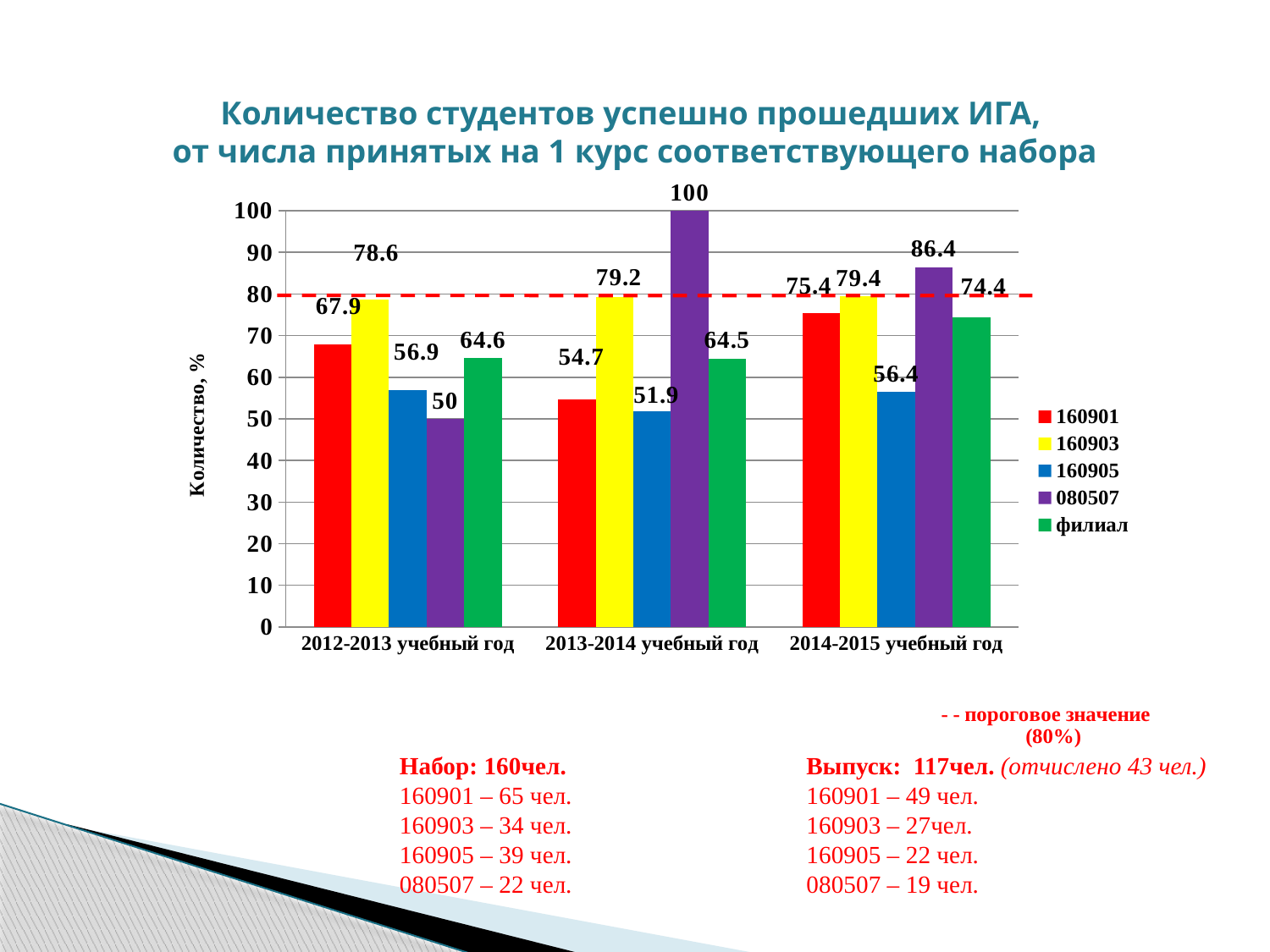
Do the values for 160903 rise or fall from 2012-2013 to 2014-2015 учебный год? rise What is the difference between the 160901 values in 2014-2015 учебный год and 2013-2014 учебный год? 20.7 What kind of chart is shown on the slide? bar chart Which series has the highest value in 2014-2015 учебный год? 080507 How many academic years (categories) are shown on the x axis? 3 Which is larger: the value for 160905 in 2012-2013 учебный год or in 2014-2015 учебный год? 2012-2013 учебный год Which series has the lowest value in 2012-2013 учебный год? 080507 What is the value for 080507 in 2013-2014 учебный год? 100 How many series does the legend list? 5 What is the value for 160903 in 2012-2013 учебный год? 78.6 What threshold value does the red dashed line on the chart mark? 80% What is the value for филиал in 2014-2015 учебный год? 74.4